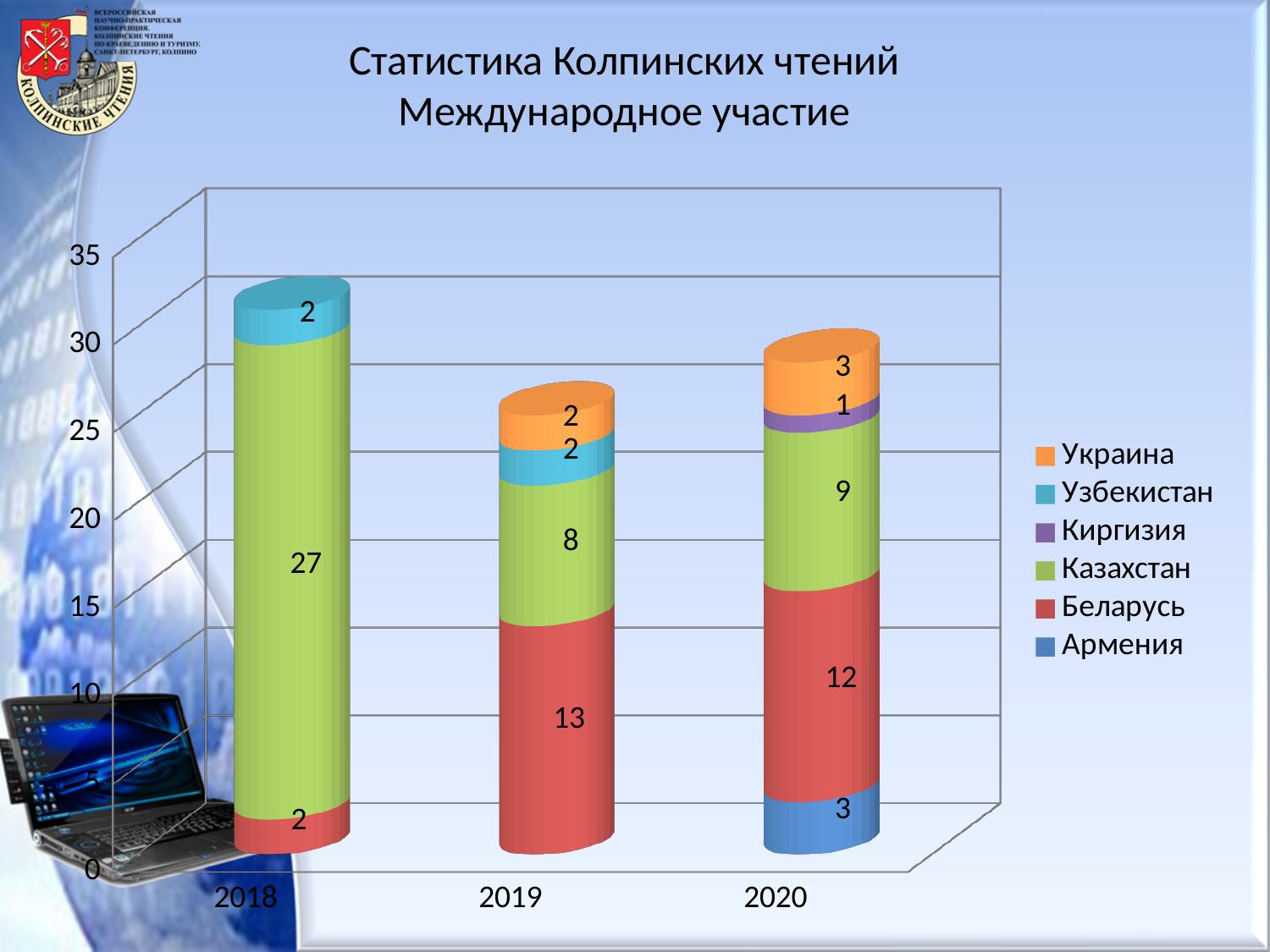
Which is larger, the Беларусь value in 2019 or in 2020? 2019 In which year is the Казахстан value highest? 2018 What is the difference between the Казахстан values for 2018 and 2019? 19 What kind of chart is shown on the slide? stacked bar chart What is the value for Киргизия in 2020? 1 What is the total of the stacked bar for 2020? 28 What is the total of the stacked bar for 2018? 31 How many series does the legend list? 6 What is the value for Казахстан in 2018? 27 What is the value for Армения in 2020? 3 How many years are shown on the x axis? 3 What is the value for Беларусь in 2019? 13